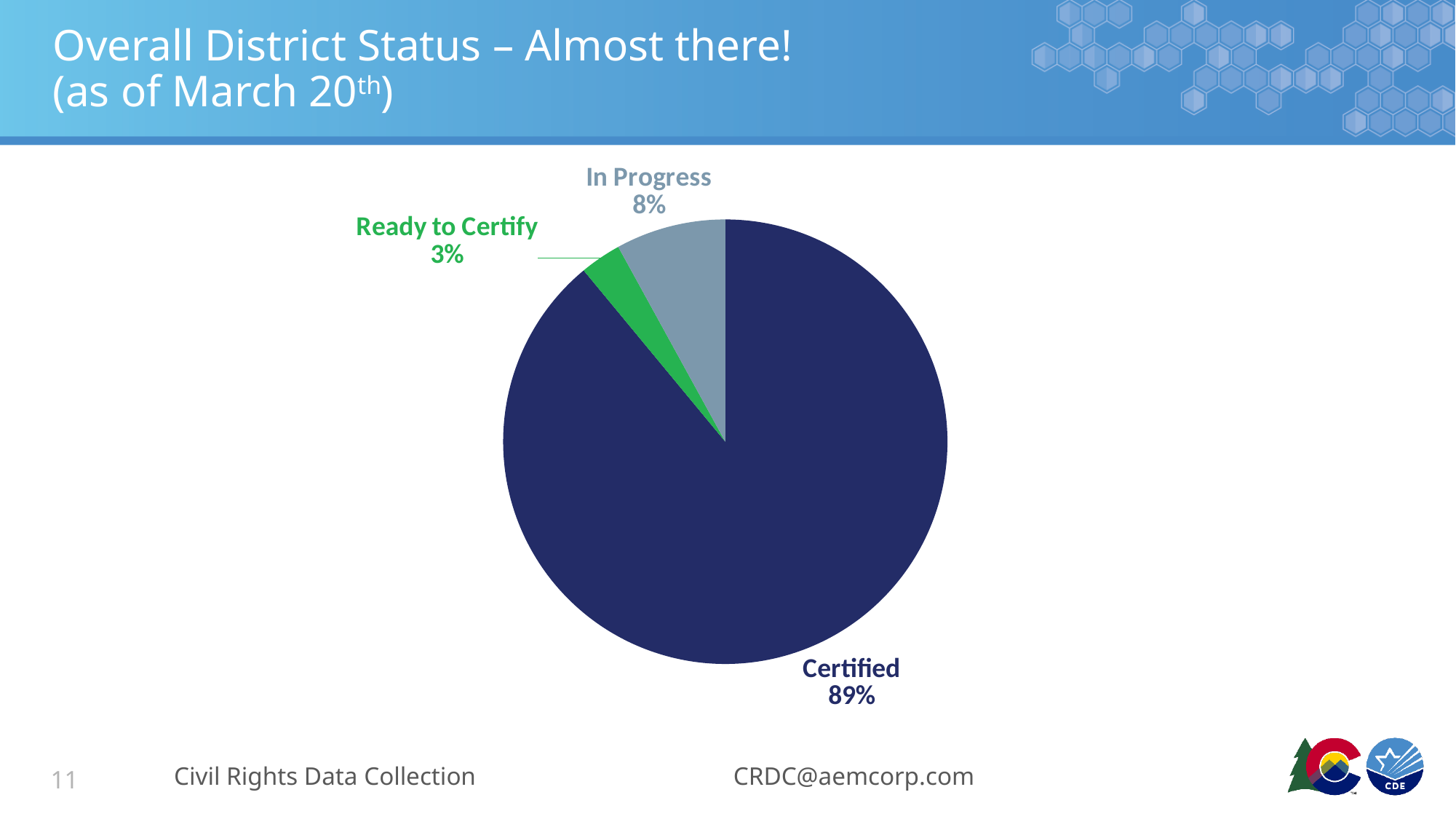
What percentage of districts are Ready to Certify? 3% What kind of chart is shown on the slide? Pie chart What is the difference in percentage points between In Progress and Ready to Certify? 5 What percentage of districts are In Progress? 8% What percentage of districts are Certified? 89% Which status has the smallest share of the pie? Ready to Certify Which is larger, the In Progress share or the Ready to Certify share? In Progress Which status has the largest share of the pie? Certified What colour is the Ready to Certify slice? Green How many slices does the pie chart have? 3 What colour is the Certified slice? Dark navy blue What is the difference in percentage points between Certified and In Progress? 81